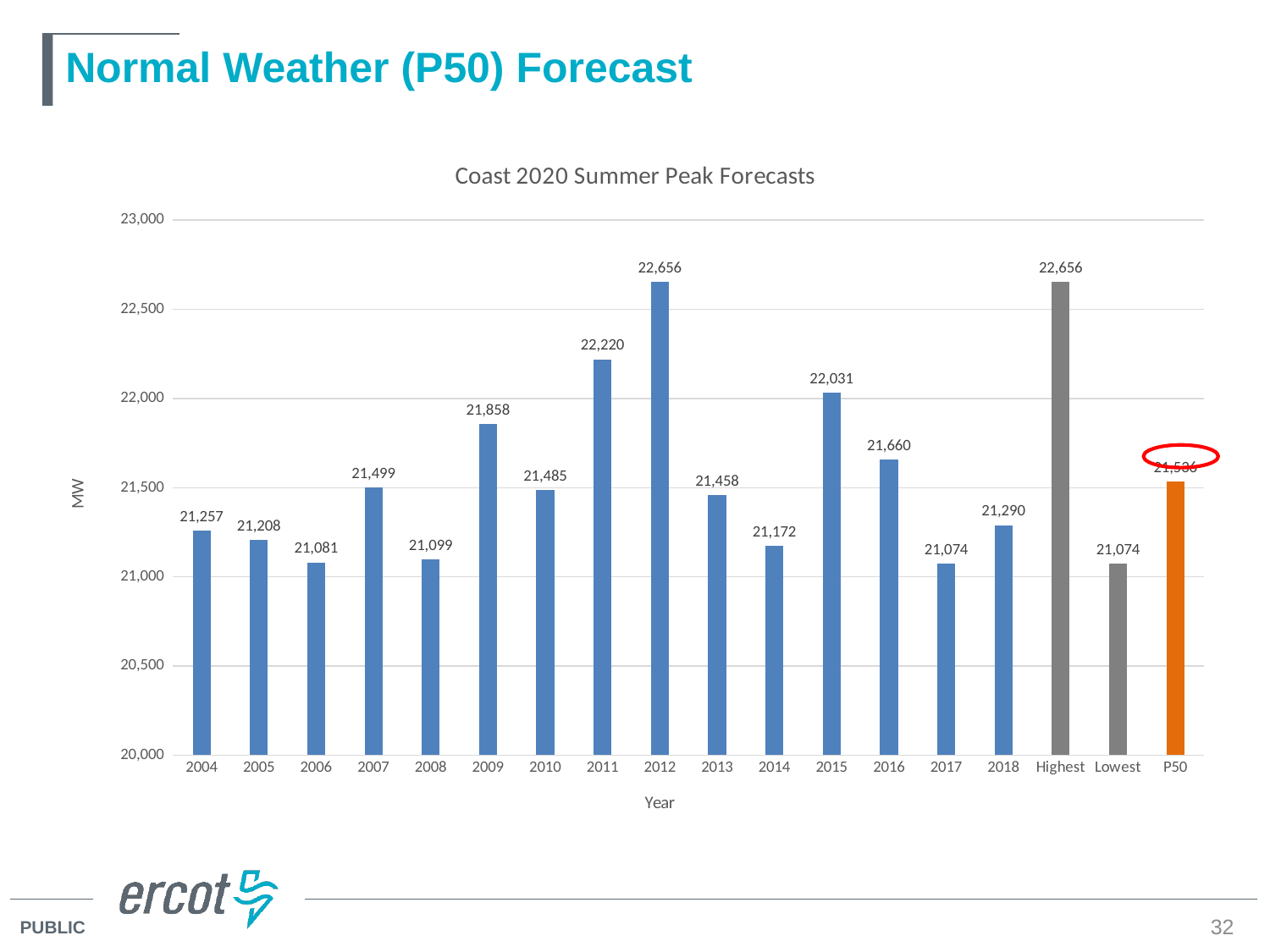
What is the forecast value for 2009? 21,858 What is the title of the chart? Coast 2020 Summer Peak Forecasts What is the forecast value for 2017? 21,074 How many bars are plotted in the chart? 18 Which year has the lowest forecast value? 2017 Is the value for 2014 greater or less than 21,500? less What is the difference between the Highest and Lowest bars? 1,582 Which is larger, the value for 2011 or the value for 2015? 2011 Which year has the highest forecast value? 2012 What is the label of the y axis? MW What is the forecast value for 2012? 22,656 What type of chart is shown on the slide? bar chart